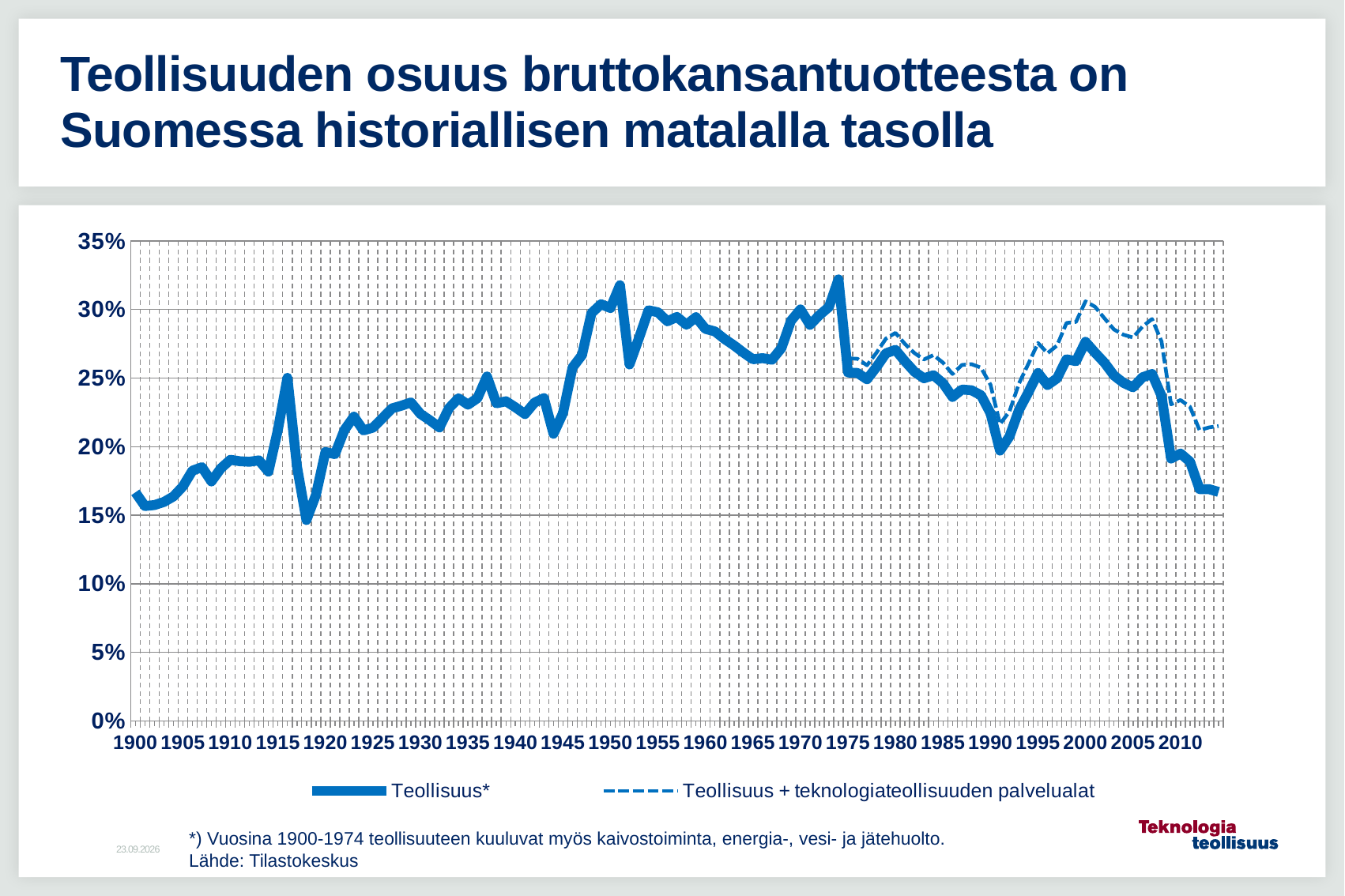
Is the value of Teollisuus* in 1900 greater or less than 20%? less Which series is drawn with a dashed line? Teollisuus + teknologiateollisuuden palvelualat Is the value of Teollisuus + teknologiateollisuuden palvelualat in 2000 greater or less than 25%? greater What source is cited below the chart? Tilastokeskus What kind of chart is shown on the slide? Line chart Is the last plotted value of Teollisuus* (around 2013) greater or less than 20%? less In 2000, which series has the higher value: Teollisuus* or Teollisuus + teknologiateollisuuden palvelualat? Teollisuus + teknologiateollisuuden palvelualat Does the Teollisuus* line rise or fall between 2000 and the end of the series? fall How many series does the legend list? 2 Which is larger for Teollisuus*: the value in 1900 or the value in 1950? 1950